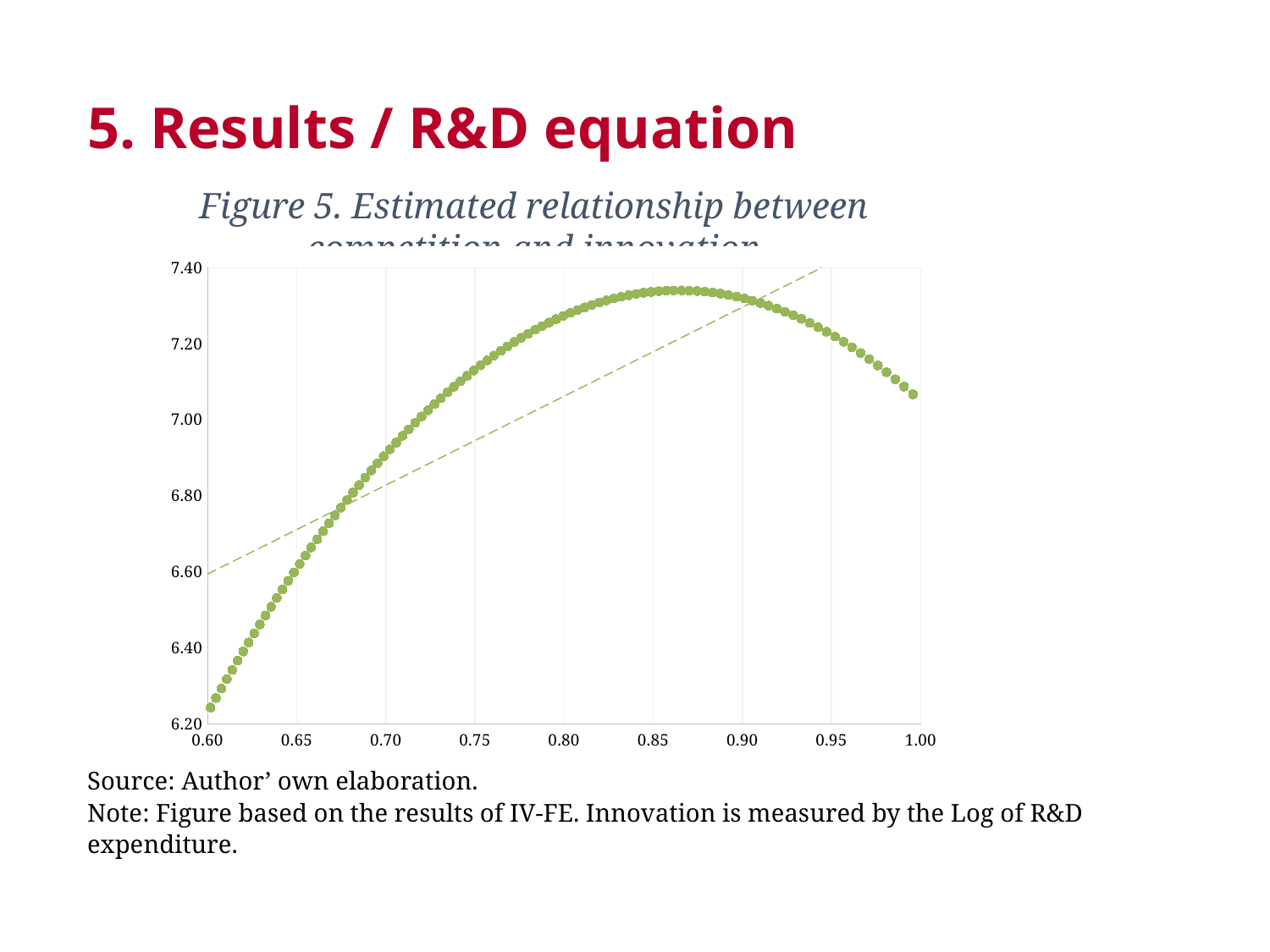
Do the plotted values rise or fall as x increases from 0.90 to 1.00? fall What is the highest value shown on the vertical axis? 7.40 Do the plotted values rise or fall as x increases from 0.60 to 0.85? rise What is the figure number given in the chart title? Figure 5 Which has the larger plotted value, x = 0.70 or x = 0.95? 0.95 Which has the larger plotted value, x = 0.60 or x = 1.00? 1.00 Is the plotted value at x = 0.60 greater or less than 6.40? less Is the plotted value at x = 0.75 greater or less than 7.00? greater What kind of chart is shown on the slide? Scatter chart Is the plotted value at x = 1.00 greater or less than 7.20? less